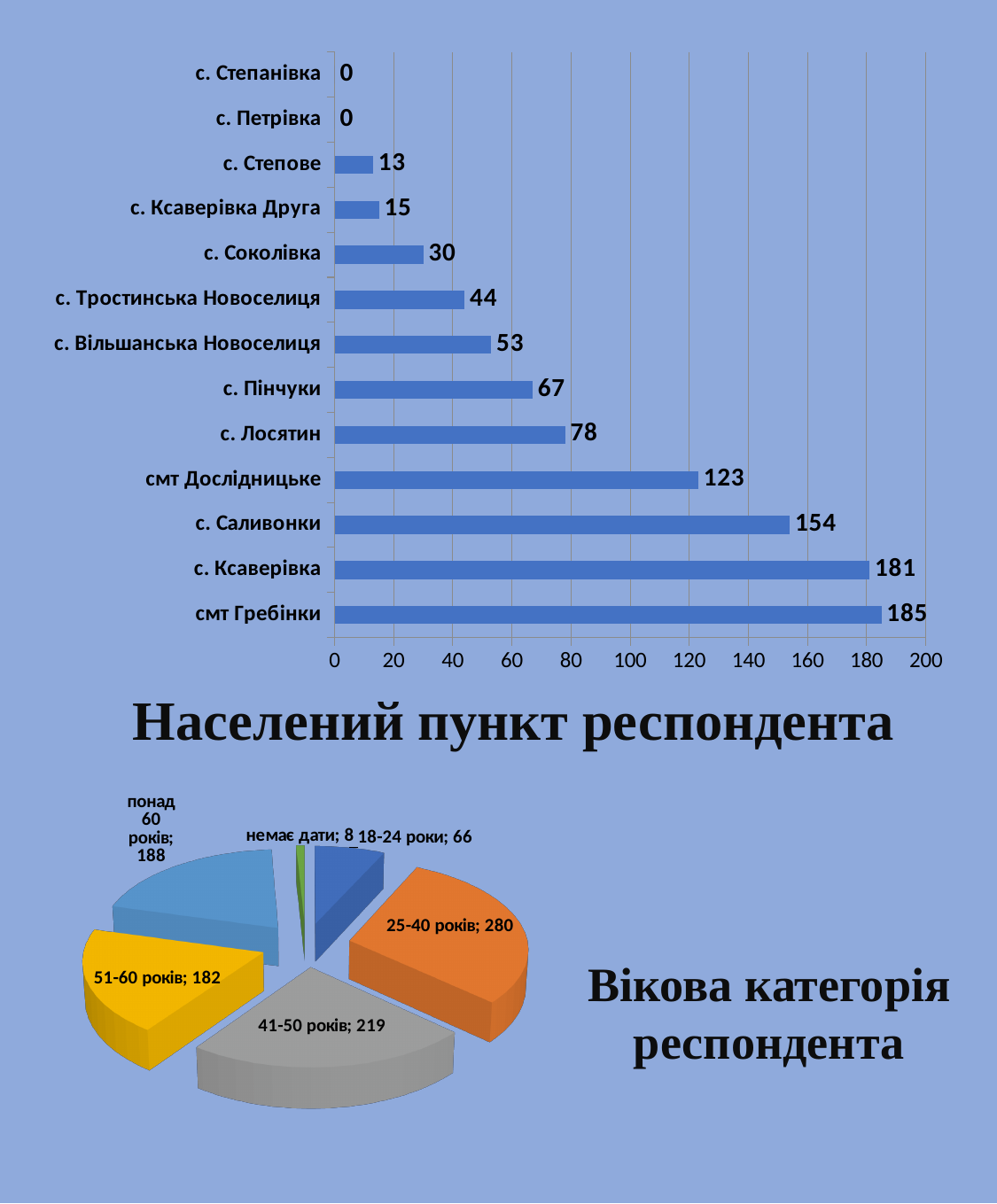
In the bar chart 'Населений пункт респондента', which is larger: с. Пінчуки or с. Соколівка? с. Пінчуки In the pie chart 'Вікова категорія респондента', what is the difference between понад 60 років and 51-60 років? 6 In the pie chart 'Вікова категорія респондента', which age category has the largest slice? 25-40 років In the bar chart 'Населений пункт респондента', what is the value for смт Дослідницьке? 123 In the bar chart 'Населений пункт респондента', how many settlements have a value of 0? 2 In the pie chart 'Вікова категорія респондента', what is the value for 41-50 років? 219 In the bar chart 'Населений пункт респондента', what is the difference between смт Гребінки and с. Ксаверівка? 4 In the bar chart 'Населений пункт респондента', what is the value for с. Лосятин? 78 What type of chart is 'Населений пункт респондента'? bar chart In the bar chart 'Населений пункт респондента', which settlement has the highest value? смт Гребінки In the bar chart 'Населений пункт респондента', how many settlements are listed? 13 In the pie chart 'Вікова категорія респондента', which category has the smallest slice? немає дати